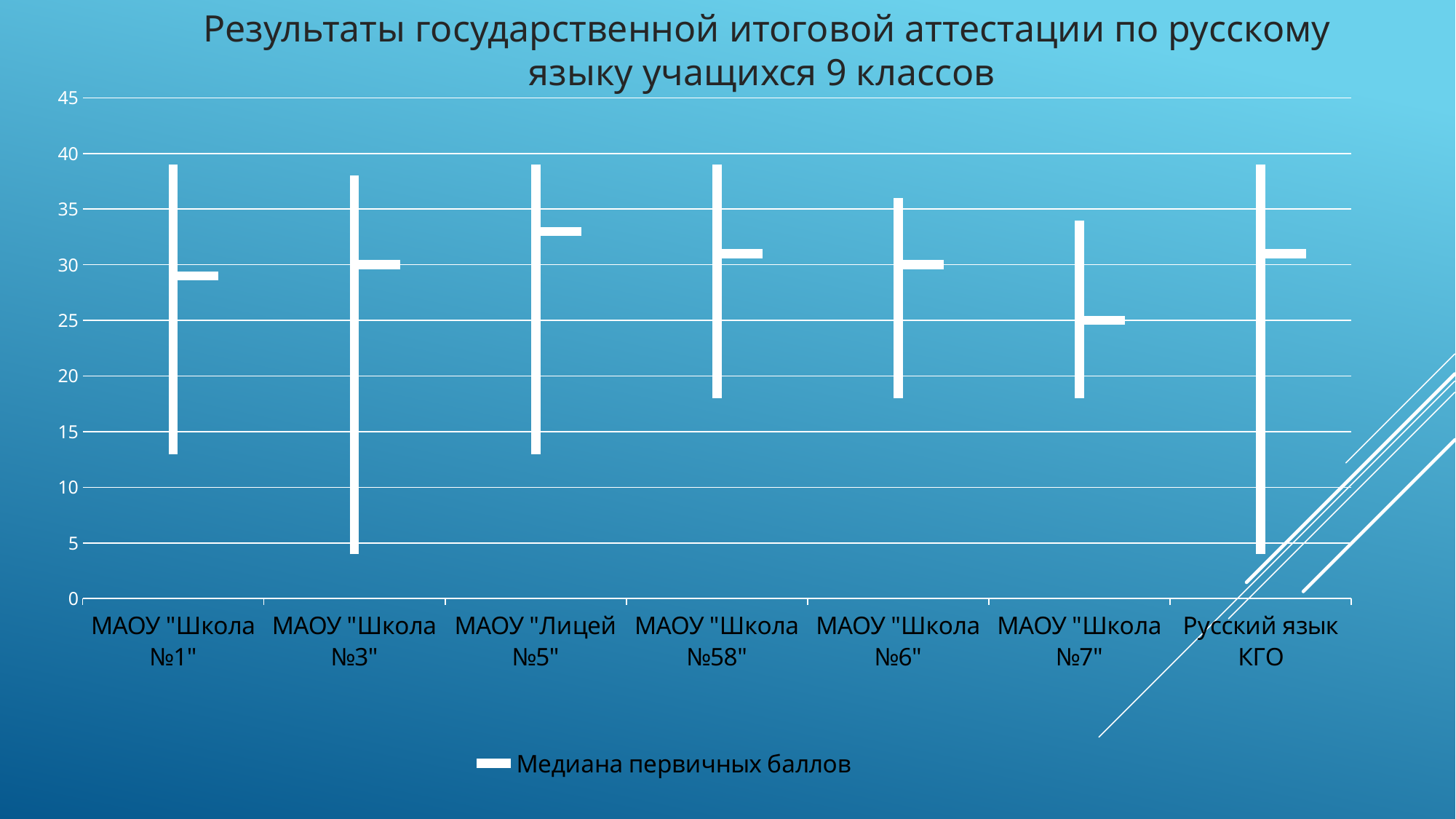
What is the title of the chart? Результаты государственной итоговой аттестации по русскому языку учащихся 9 классов What series does the legend list? Медиана первичных баллов Is the top of the range for МАОУ "Школа №6" greater or less than 40? less Which category has the lowest median (Медиана первичных баллов)? МАОУ "Школа №7" Is the median for МАОУ "Школа №7" greater or less than 20? greater How many categories are shown on the x axis? 7 Which has the larger median: МАОУ "Школа №58" or МАОУ "Школа №7"? МАОУ "Школа №58" Which category has the highest median (Медиана первичных баллов)? МАОУ "Лицей №5" Is the median for МАОУ "Школа №7" greater or less than 30? less Which has the larger median: МАОУ "Лицей №5" or МАОУ "Школа №7"? МАОУ "Лицей №5" How many series does the legend list? 1